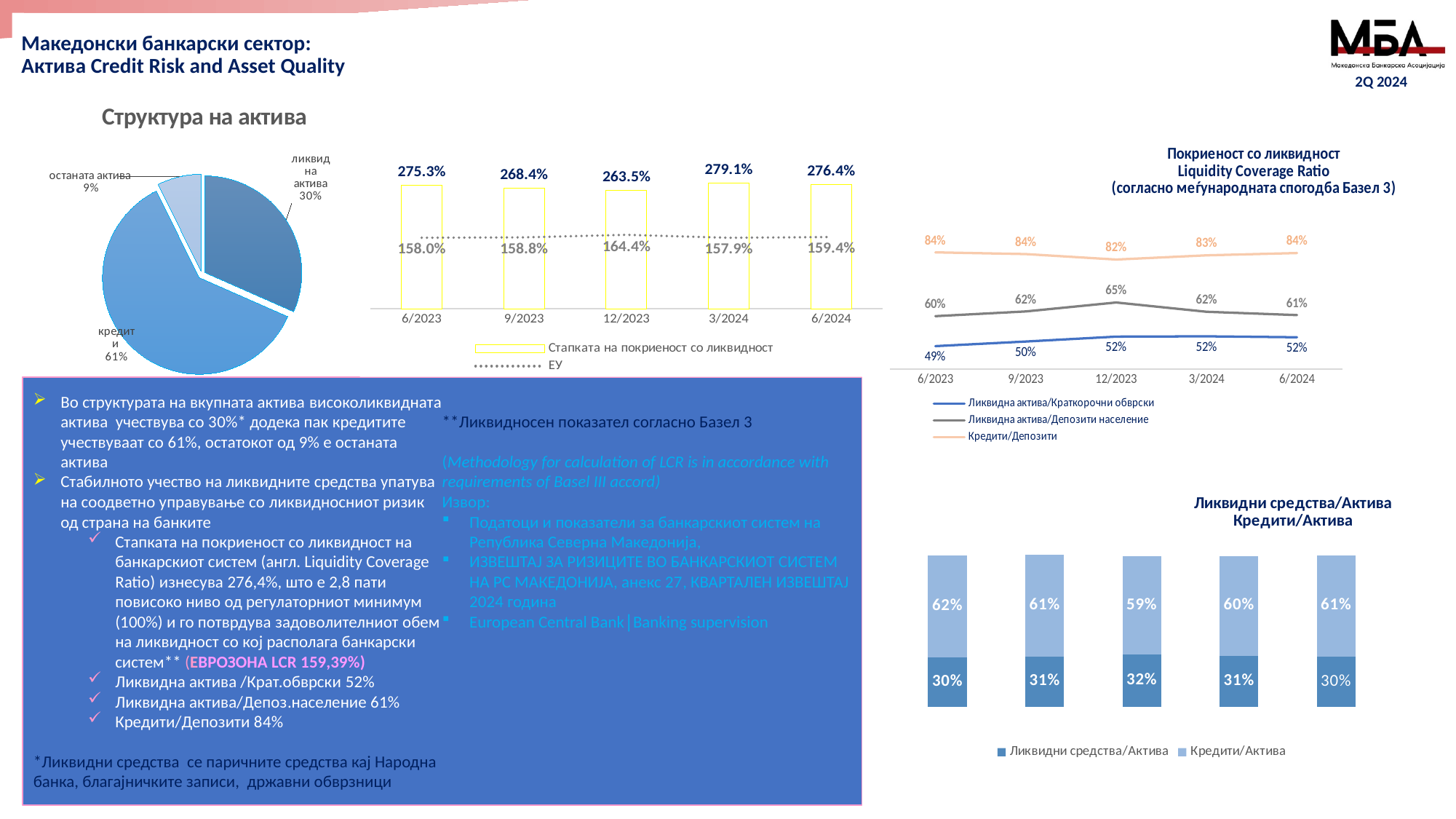
In the bar chart with the yellow bars, what is the ЕУ value for 3/2024? 157.9% In the stacked bar chart 'Ликвидни средства/Актива Кредити/Актива', what is the total of the first bar? 92% In the line chart 'Покриеност со ликвидност Liquidity Coverage Ratio', what is the value of Ликвидна актива/Депозити население for 12/2023? 65% In the line chart 'Покриеност со ликвидност Liquidity Coverage Ratio', does the Ликвидна актива/Краткорочни обврски series rise or fall from 6/2023 to 6/2024? rise In the bar chart with the yellow bars, which period has the highest value for Стапката на покриеност со ликвидност? 3/2024 In the stacked bar chart 'Ликвидни средства/Актива Кредити/Актива', how many bars are shown? 5 In the pie chart 'Структура на актива', which category has the smallest share? останата актива In the stacked bar chart 'Ликвидни средства/Актива Кредити/Актива', what is the value of Кредити/Актива in the middle bar? 59% In the pie chart 'Структура на актива', what share does 'кредити' hold? 61% In the line chart 'Покриеност со ликвидност Liquidity Coverage Ratio', how many series does the legend list? 3 In the bar chart with the yellow bars, what is the difference between the Стапката на покриеност со ликвидност and the ЕУ value for 12/2023? 99.1% In the bar chart with the yellow bars (Стапката на покриеност со ликвидност), what is the value for 6/2024? 276.4%